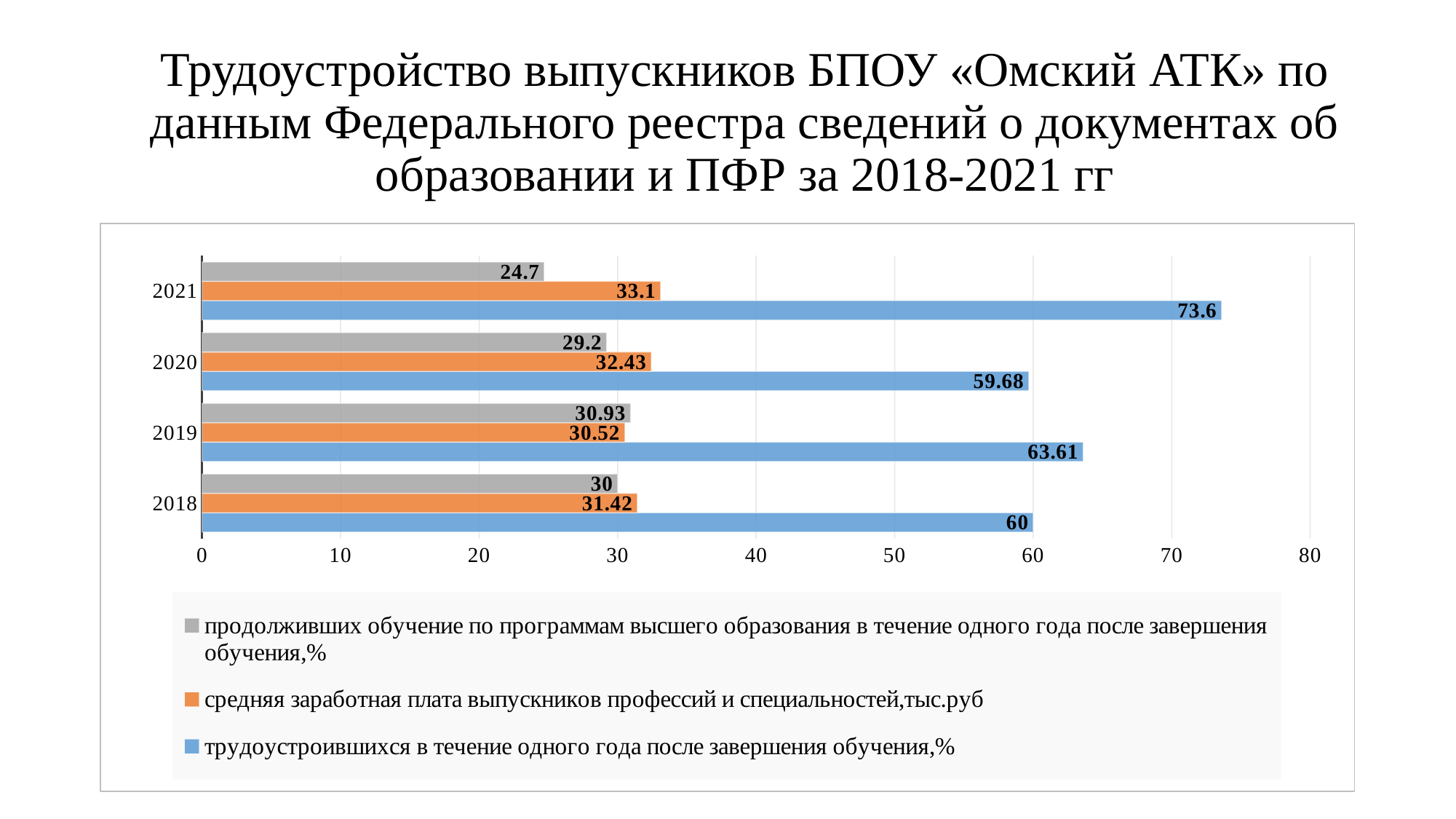
What is the value for 'средняя заработная плата выпускников профессий и специальностей,тыс.руб' in 2020? 32.43 How many series does the legend list? 3 What is the value for 'продолживших обучение по программам высшего образования в течение одного года после завершения обучения,%' in 2019? 30.93 What is the difference between the 2021 and 2020 values for 'трудоустроившихся в течение одного года после завершения обучения,%'? 13.92 What colour represents the series 'средняя заработная плата выпускников профессий и специальностей,тыс.руб'? orange Which is larger in 2018: the value for 'средняя заработная плата выпускников профессий и специальностей,тыс.руб' or the value for 'продолживших обучение по программам высшего образования в течение одного года после завершения обучения,%'? средняя заработная плата выпускников профессий и специальностей,тыс.руб What type of chart is shown on the slide? bar chart In which year is the value for 'трудоустроившихся в течение одного года после завершения обучения,%' the highest? 2021 How many years are shown on the vertical axis of the chart? 4 Is the 2019 value for 'трудоустроившихся в течение одного года после завершения обучения,%' greater or less than 60? greater What is the value for 'трудоустроившихся в течение одного года после завершения обучения,%' in 2021? 73.6 In which year is the value for 'продолживших обучение по программам высшего образования в течение одного года после завершения обучения,%' the lowest? 2021